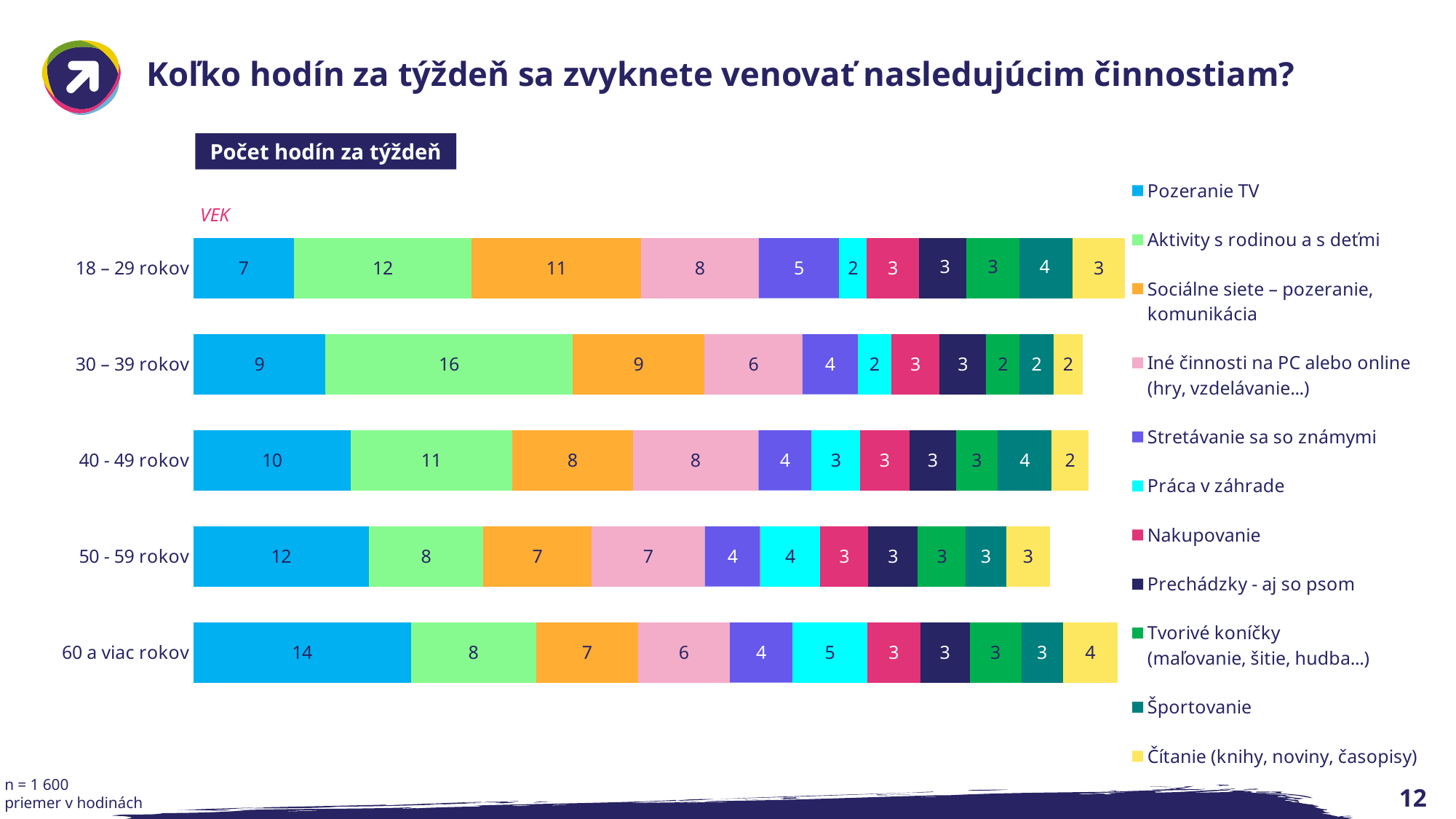
Which is larger: Práca v záhrade for 60 a viac rokov or for 18 – 29 rokov? 60 a viac rokov How many age categories are plotted on the chart? 5 What is the value for Pozeranie TV in the 60 a viac rokov category? 14 Which age category has the lowest value for Pozeranie TV? 18 – 29 rokov What is the difference between the Pozeranie TV values for 60 a viac rokov and 18 – 29 rokov? 7 What is the title shown in the box above the chart? Počet hodín za týždeň How many series does the legend list? 11 What is the total of the stacked bar for 18 – 29 rokov? 61 What type of chart is shown on the slide? stacked bar chart What is the value for Aktivity s rodinou a s deťmi in the 30 – 39 rokov category? 16 What is the value for Sociálne siete – pozeranie, komunikácia in the 18 – 29 rokov category? 11 Which age category has the highest value for Pozeranie TV? 60 a viac rokov